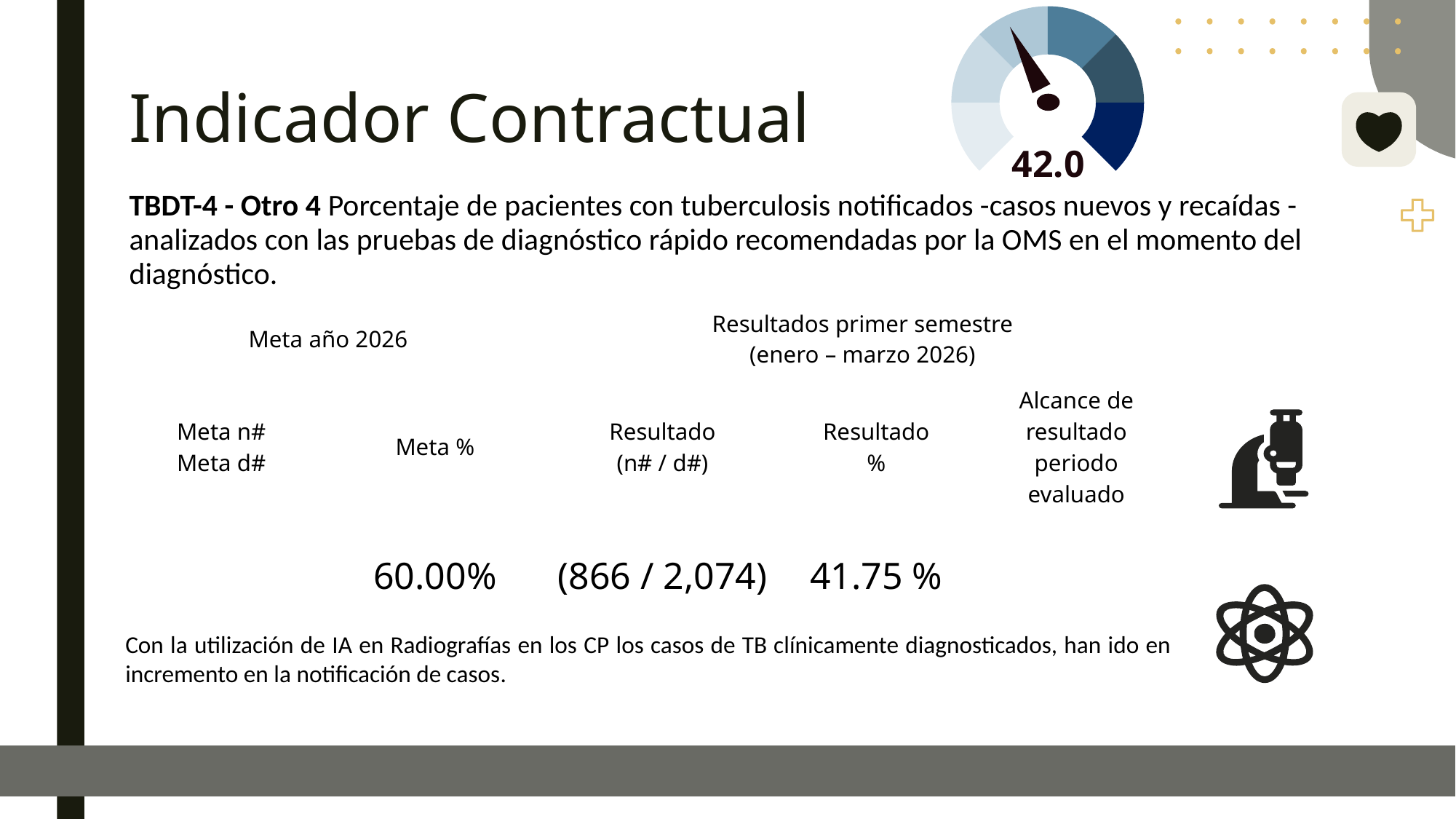
Is the value shown on the gauge chart (42.0) greater or less than the Meta % of 60.00% shown on the slide? less Where is the value label of the gauge chart positioned relative to the gauge? below the gauge What kind of chart is shown at the top of the slide next to the title? gauge chart What colour is the needle of the gauge chart? dark brown/black What value is displayed on the gauge chart at the top of the slide? 42.0